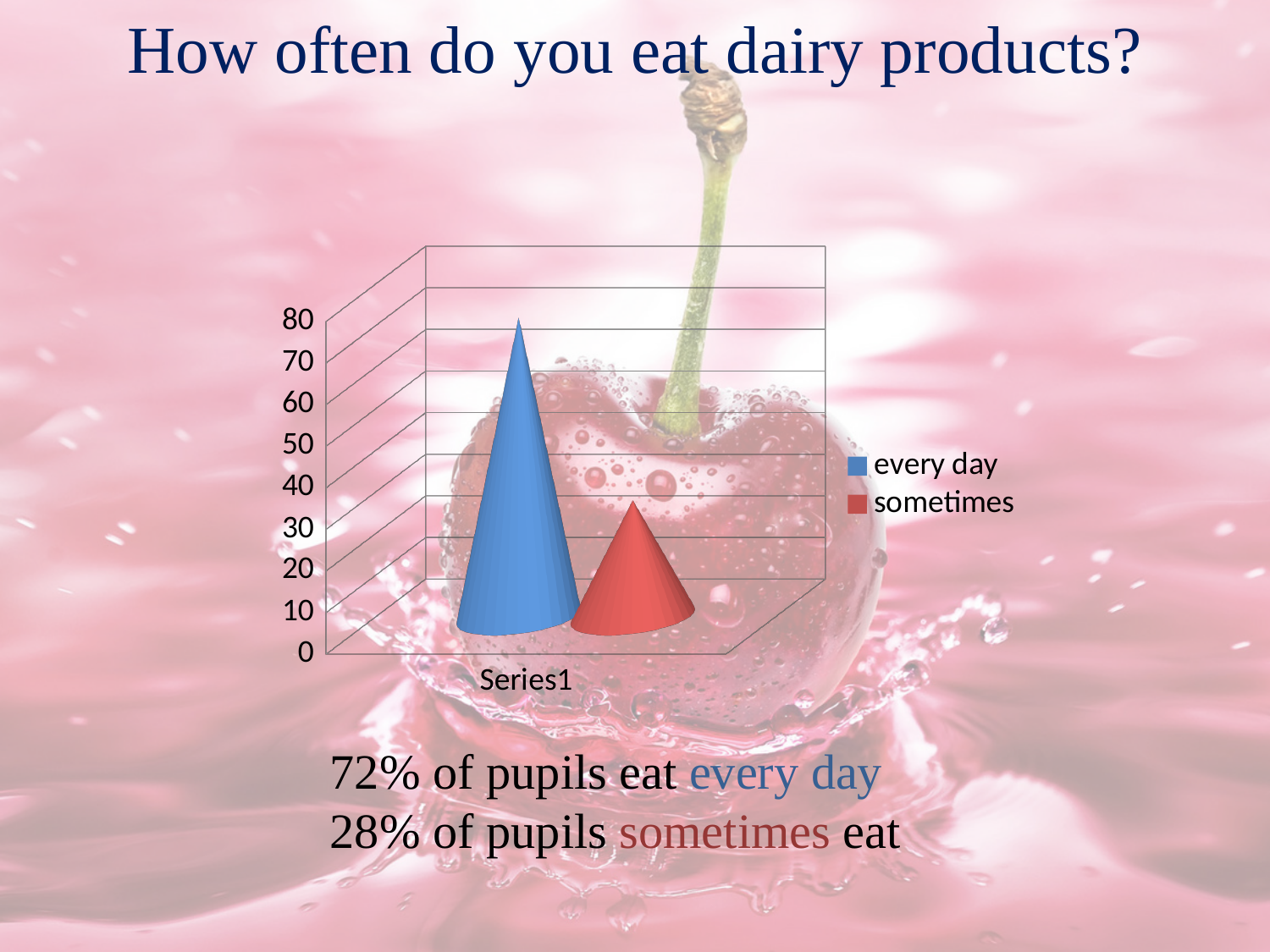
What colour represents 'every day' in the chart legend? blue Which series has the lowest value in the chart? sometimes What is the difference between the percentage of pupils who eat dairy every day and those who sometimes eat it? 44% According to the slide, what percentage of pupils sometimes eat dairy products? 28% Is the value for 'sometimes' greater or less than 50? less How many series does the chart legend list? 2 Which series has the highest value in the chart? every day According to the slide, what percentage of pupils eat dairy products every day? 72% Which is larger, the value for 'every day' or the value for 'sometimes'? every day What is the highest value shown on the chart's vertical axis? 80 Is the value for 'every day' greater or less than 40? greater What kind of chart is shown on the slide? bar chart